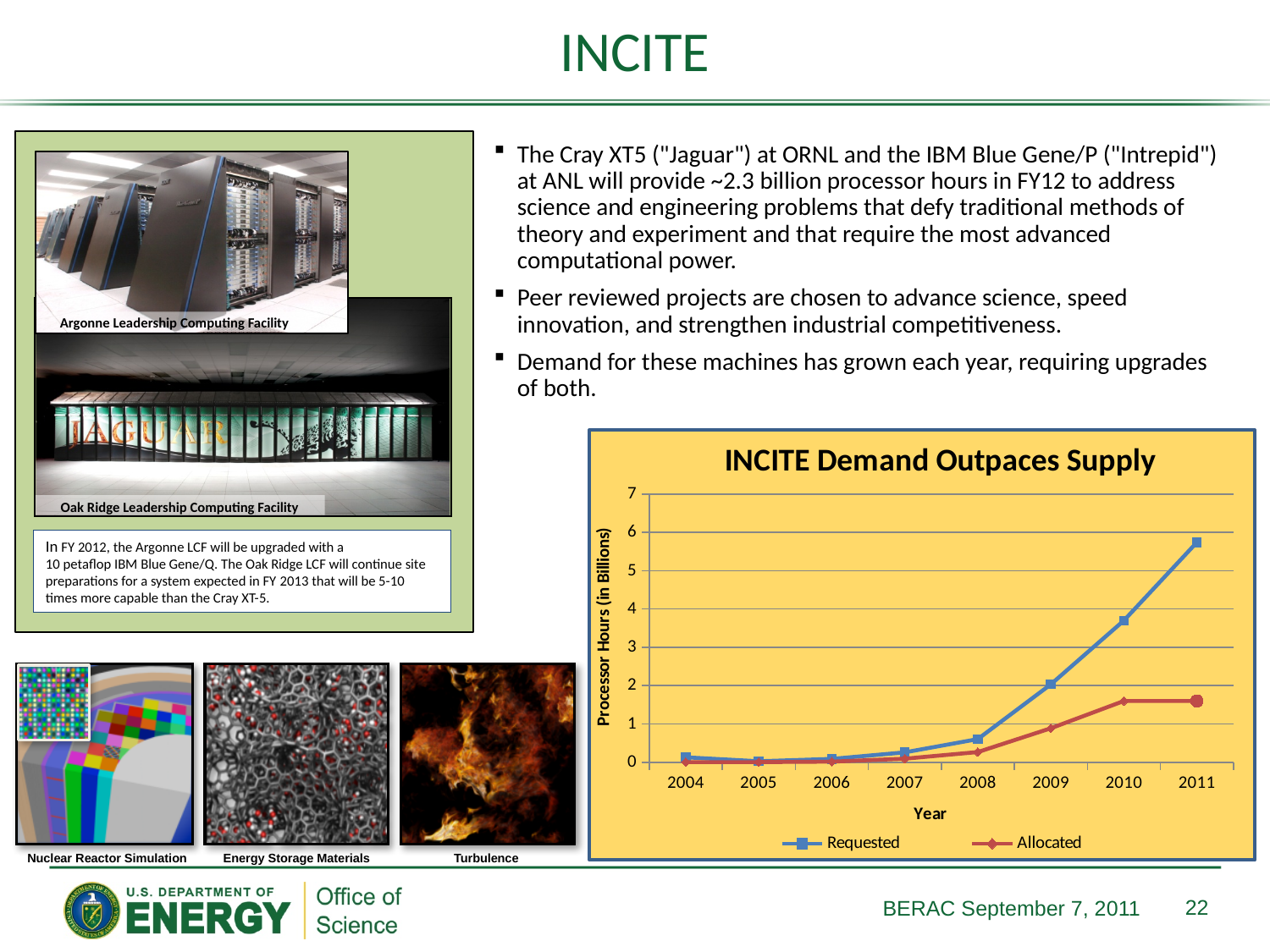
How many years are plotted along the x axis of the chart? 8 What type of chart is shown on the slide? line chart In 2011, which series has the larger value, Requested or Allocated? Requested In which year is the Requested series at its highest? 2011 What is the label of the y axis of the chart? Processor Hours (in Billions) How many series does the chart's legend list? 2 Does the Requested series rise or fall from 2008 to 2011? rise Is the Requested value for 2010 greater or less than 3? greater Is the Requested value for 2011 greater or less than 5? greater What is the title of the chart on the slide? INCITE Demand Outpaces Supply Is the Allocated value for 2011 greater or less than 2? less